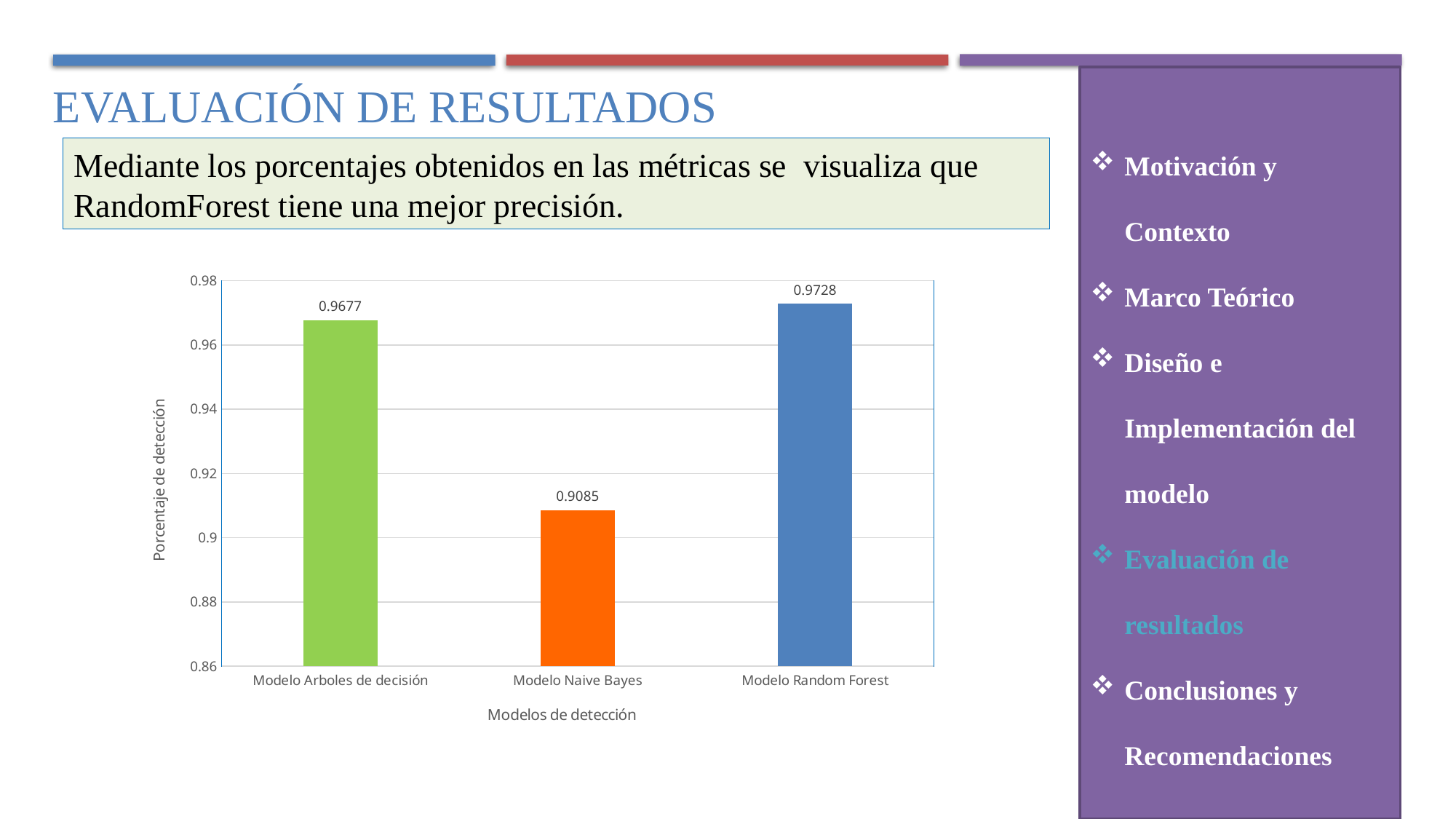
What is the difference between the values for Modelo Arboles de decisión and Modelo Naive Bayes? 0.0592 Which is larger, the value for Modelo Arboles de decisión or the value for Modelo Naive Bayes? Modelo Arboles de decisión Is the value for Modelo Naive Bayes greater or less than 0.92? less What kind of chart is shown on the slide? bar chart What is the label of the y axis? Porcentaje de detección How many models are shown on the x axis? 3 Which model has the lowest value? Modelo Naive Bayes What is the value for Modelo Arboles de decisión? 0.9677 What is the value for Modelo Naive Bayes? 0.9085 Which model has the highest value? Modelo Random Forest What is the value for Modelo Random Forest? 0.9728 What is the difference between the values for Modelo Random Forest and Modelo Naive Bayes? 0.0643